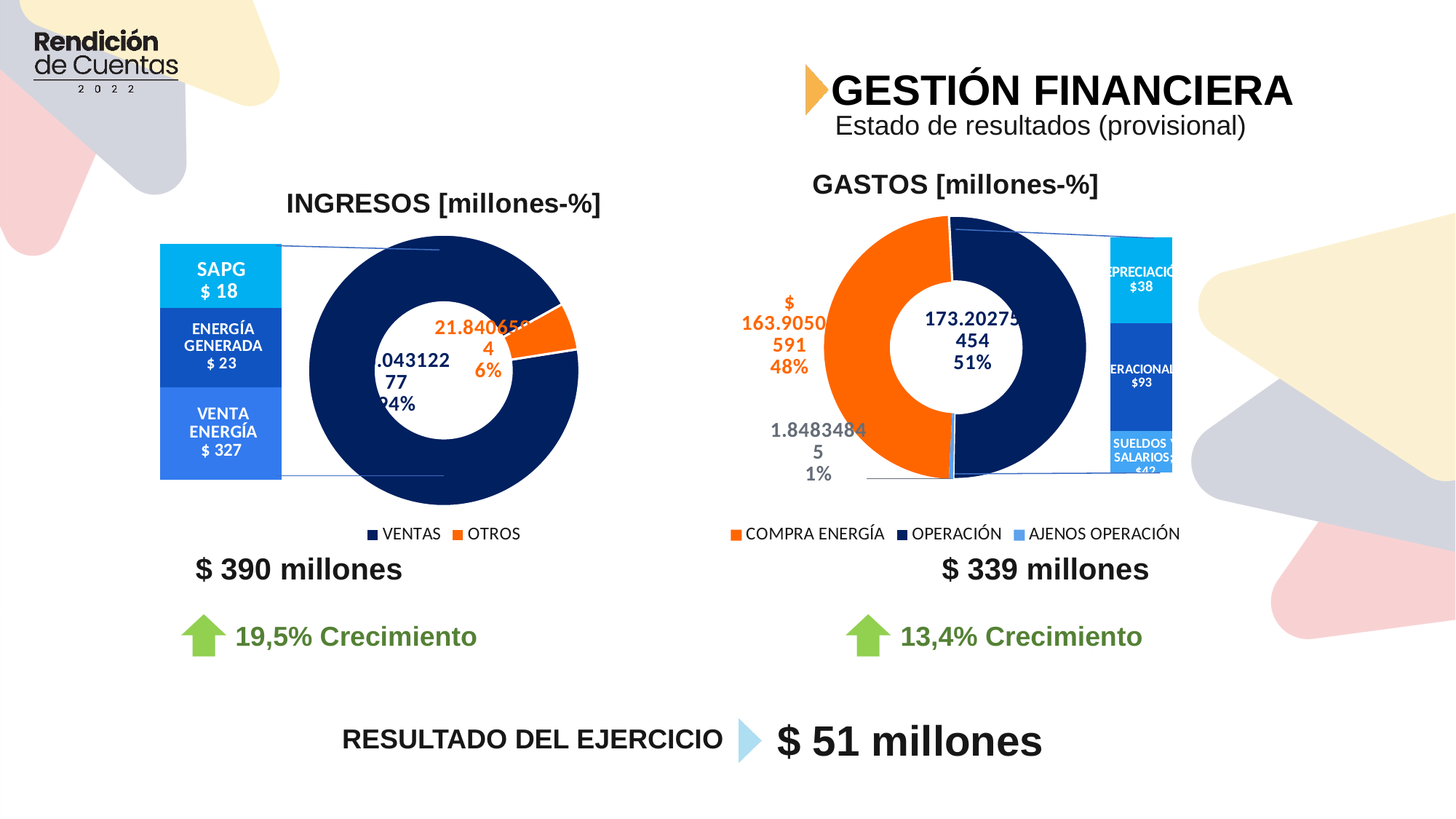
In the GASTOS [millones-%] chart, by how many percentage points does OPERACIÓN exceed COMPRA ENERGÍA? 3 percentage points What kind of chart is the INGRESOS [millones-%] chart? doughnut chart In the GASTOS [millones-%] chart, which category has the largest share? OPERACIÓN In the GASTOS [millones-%] chart, what colour is the COMPRA ENERGÍA slice? orange In the INGRESOS [millones-%] chart, what share of the pie is OTROS? 6% In the GASTOS [millones-%] chart, what share of the pie is OPERACIÓN? 51% In the GASTOS [millones-%] chart, which category has the smallest share? AJENOS OPERACIÓN In the INGRESOS [millones-%] chart, which slice is larger, VENTAS or OTROS? VENTAS How many categories does the GASTOS [millones-%] chart show? 3 How many entries does the legend of the INGRESOS [millones-%] chart list? 2 In the GASTOS [millones-%] chart, what share of the pie is COMPRA ENERGÍA? 48%